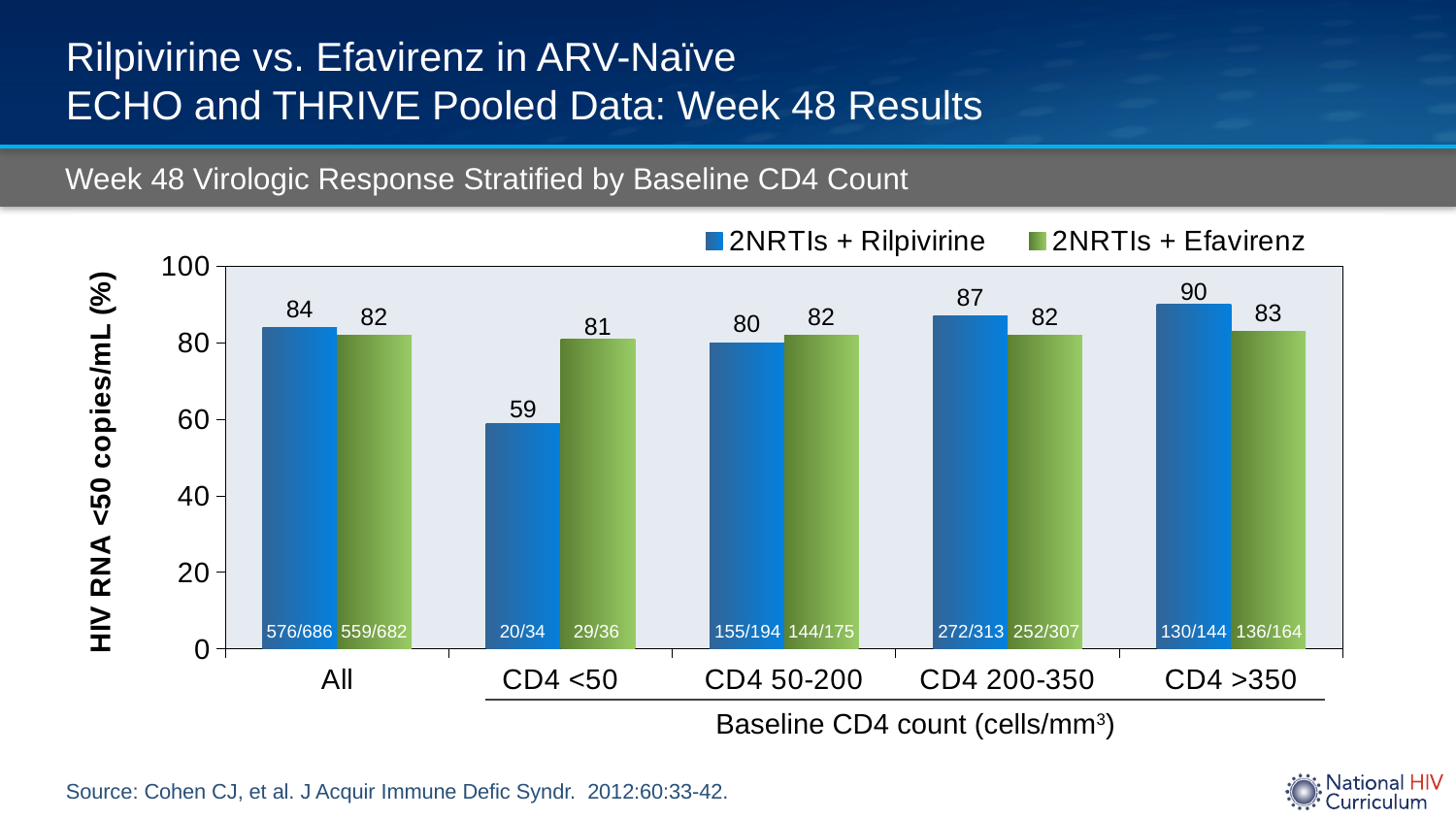
How many categories are shown on the x axis? 5 What is the difference between the 2NRTIs + Efavirenz and 2NRTIs + Rilpivirine values in the CD4 <50 category? 22 What is the value for 2NRTIs + Rilpivirine in the CD4 <50 category? 59 Which category has the highest value for 2NRTIs + Rilpivirine? CD4 >350 What is the value for 2NRTIs + Rilpivirine in the All category? 84 Which is larger in the CD4 200-350 category: 2NRTIs + Rilpivirine or 2NRTIs + Efavirenz? 2NRTIs + Rilpivirine How many series does the legend list? 2 Which category has the lowest value for 2NRTIs + Rilpivirine? CD4 <50 What kind of chart is shown on the slide? Bar chart What is the value for 2NRTIs + Efavirenz in the CD4 >350 category? 83 What is the y-axis label of the chart? HIV RNA <50 copies/mL (%) Is the value for 2NRTIs + Rilpivirine in the CD4 <50 category greater or less than 80? less